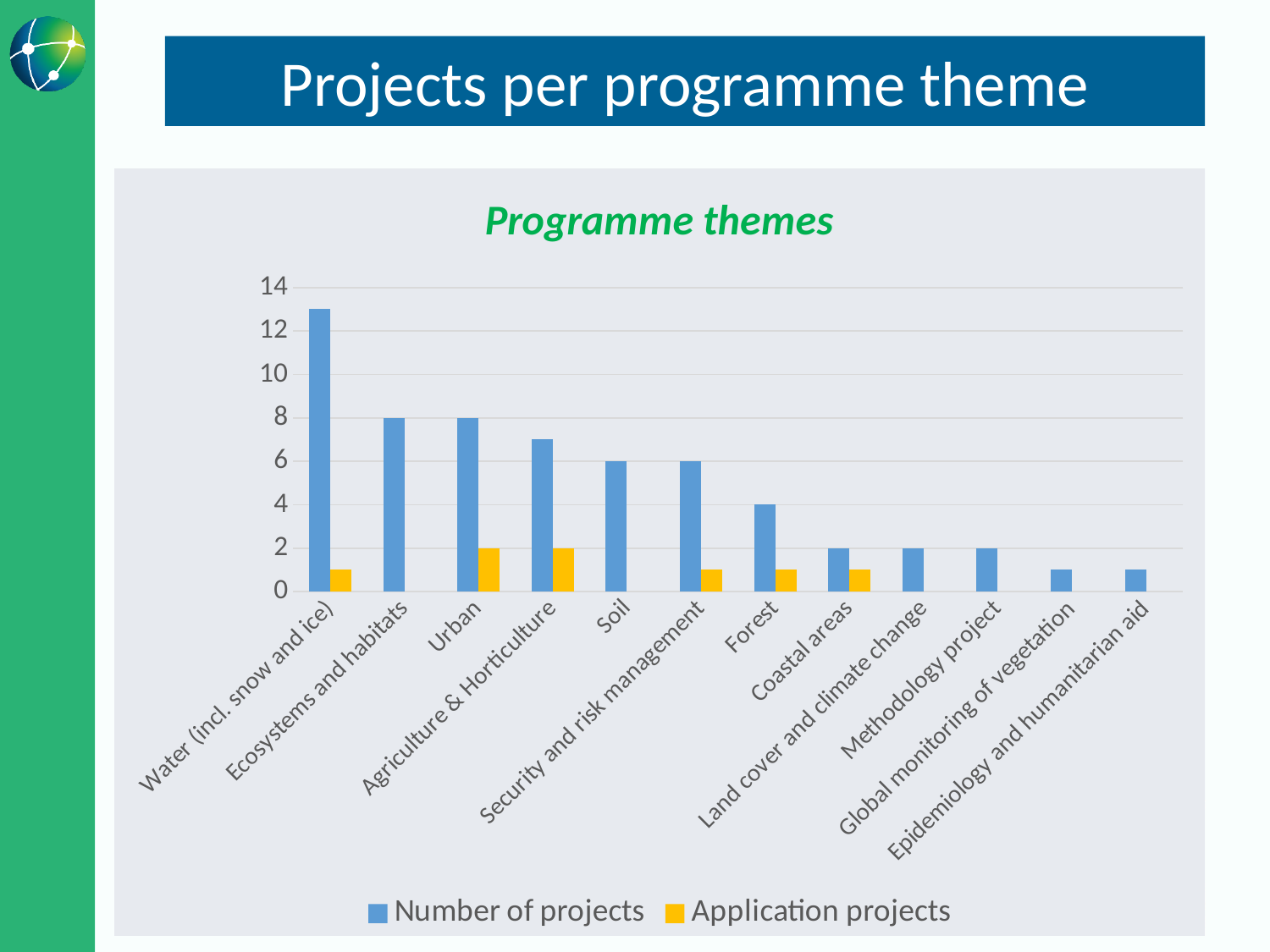
What type of chart is shown on the slide? bar chart What is the number of projects for Soil? 6 What is the difference between the number of projects for Ecosystems and habitats and for Forest? 4 How many programme themes are shown on the x axis? 12 How many application projects are there for Urban? 2 How many series does the legend list? 2 Which programme theme has the highest number of projects? Water (incl. snow and ice) Is the number of projects for Agriculture & Horticulture greater or less than 6? greater What is the number of projects for Ecosystems and habitats? 8 Do the number of projects values generally rise or fall from left to right along the x axis? fall What is the number of projects for Forest? 4 Is the number of projects for Water (incl. snow and ice) greater or less than 12? greater